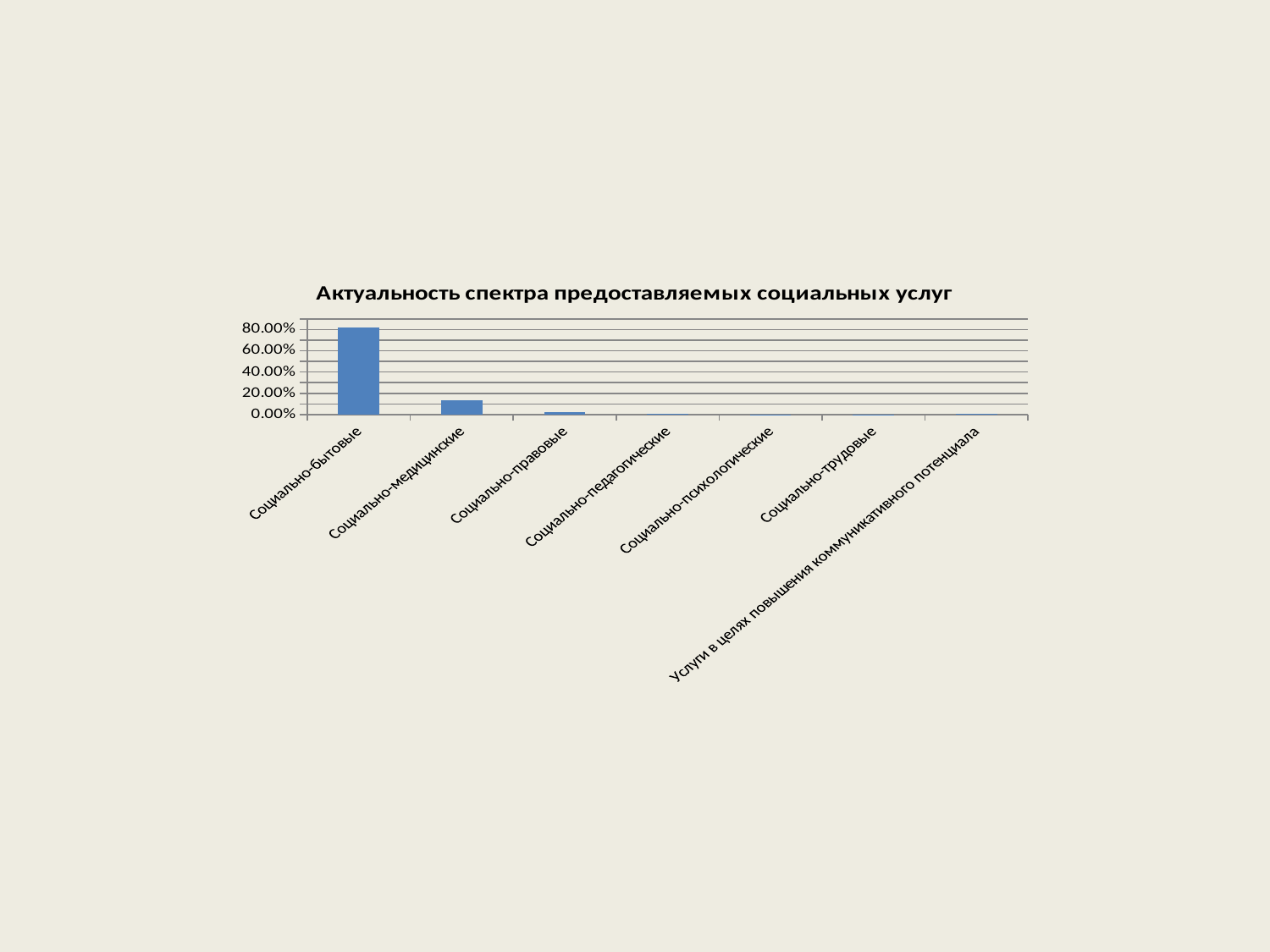
How many categories are shown on the x axis of the chart? 7 Is the value for Социально-медицинские greater or less than 20.00%? less What is the title of the chart? Актуальность спектра предоставляемых социальных услуг Which is larger, the value for Социально-бытовые or the value for Социально-медицинские? Социально-бытовые Is the value for Социально-бытовые greater or less than 60.00%? greater Which category has the highest value in the chart? Социально-бытовые Which is larger, the value for Социально-медицинские or the value for Социально-правовые? Социально-медицинские Is the value for Социально-правовые greater or less than 20.00%? less Do the values generally rise or fall moving from left to right along the x axis? fall What kind of chart is shown on the slide? bar chart What is the highest value shown on the vertical axis of the chart? 80.00%